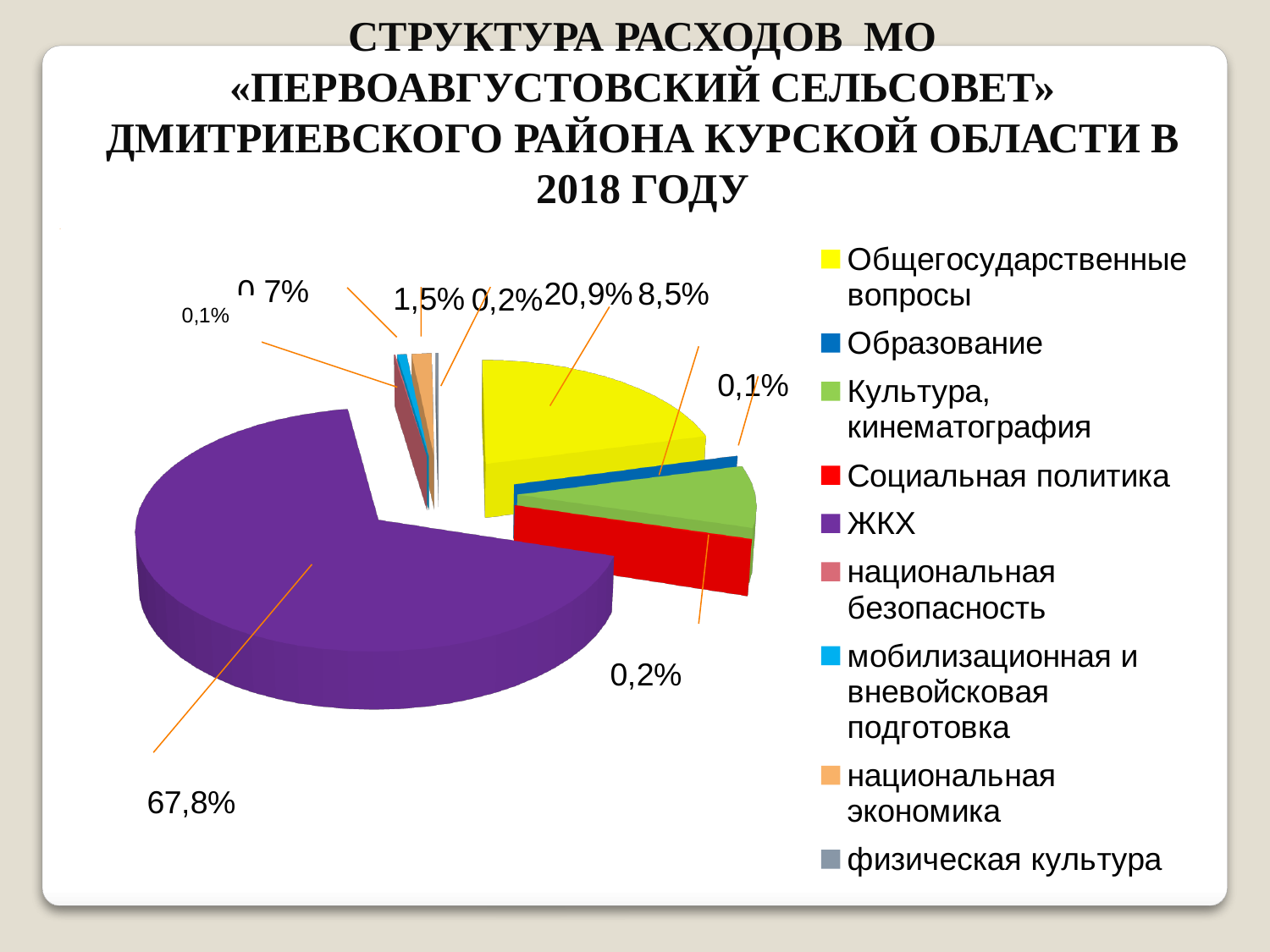
What kind of chart is shown on the slide? pie chart What share of expenditures does ЖКХ account for? 67,8% How many categories does the legend list? 9 Which category has the largest share of expenditures? ЖКХ What colour is the ЖКХ slice? purple What is the difference between the share for ЖКХ and the share for Общегосударственные вопросы? 46,9% Which year does the chart title refer to? 2018 Which is larger, the share for ЖКХ or the share for Общегосударственные вопросы? ЖКХ What share of expenditures does Общегосударственные вопросы account for? 20,9%